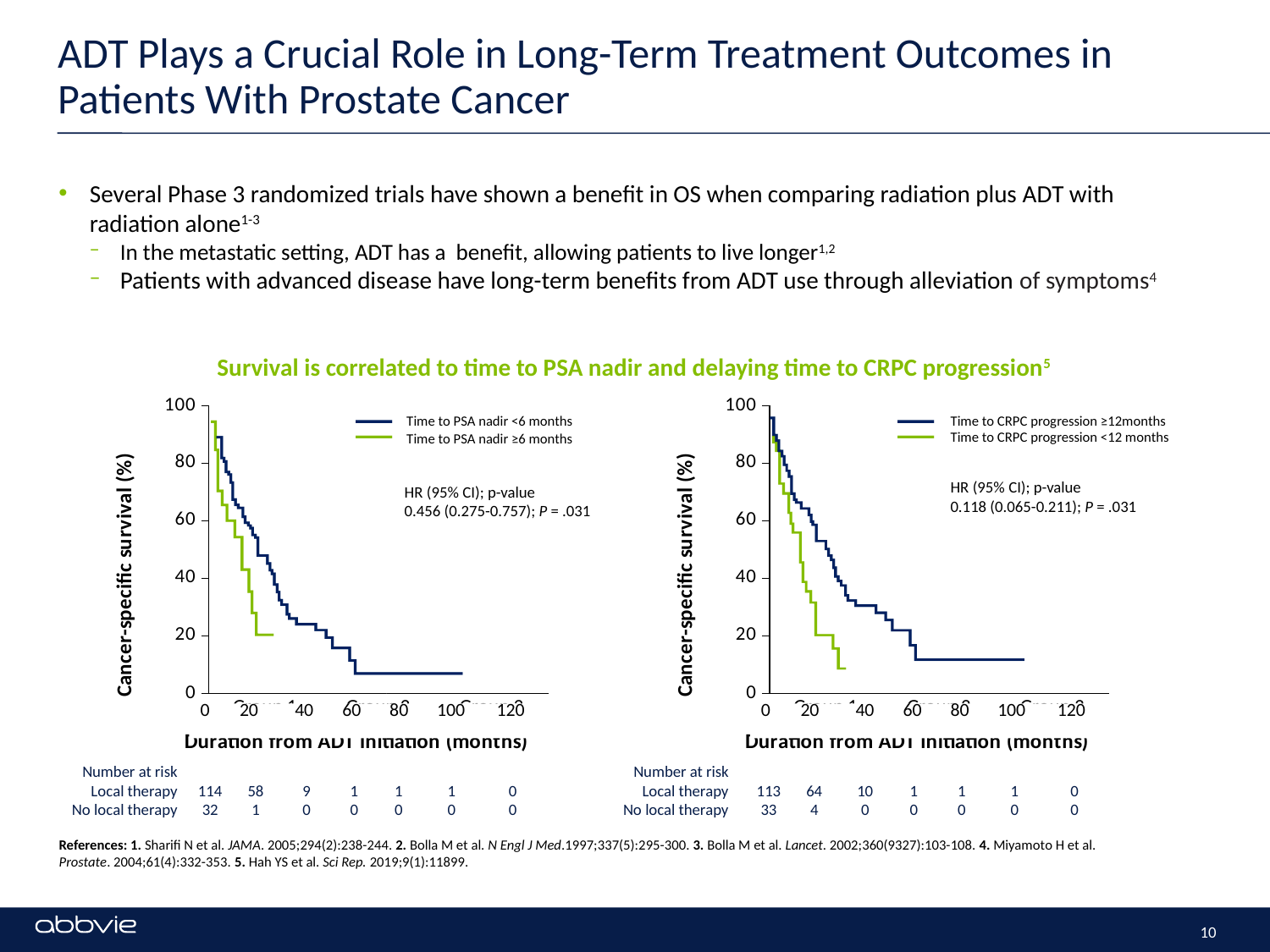
In the right chart, what is the number at risk for No local therapy at 20 months? 4 How many series does the legend of the left chart list? 2 In the right chart, what is the HR (95% CI) printed on the chart? 0.118 (0.065-0.211) What is the label of the y axis on the left chart? Cancer-specific survival (%) In the right chart, is the cancer-specific survival for the Time to CRPC progression ≥12 months series at 80 months greater or less than 20%? less In the left chart, what is the HR (95% CI) printed on the chart? 0.456 (0.275-0.757) In the left chart, what is the difference between the number at risk for Local therapy and No local therapy at 0 months? 82 Do the survival curves in the right chart rise or fall as duration from ADT initiation increases? fall In the left chart, what is the number at risk for Local therapy at 0 months? 114 What kind of chart is the left chart on the slide? line chart In the left chart, what is the P-value printed on the chart? P = .031 How many series does the legend of the right chart list? 2